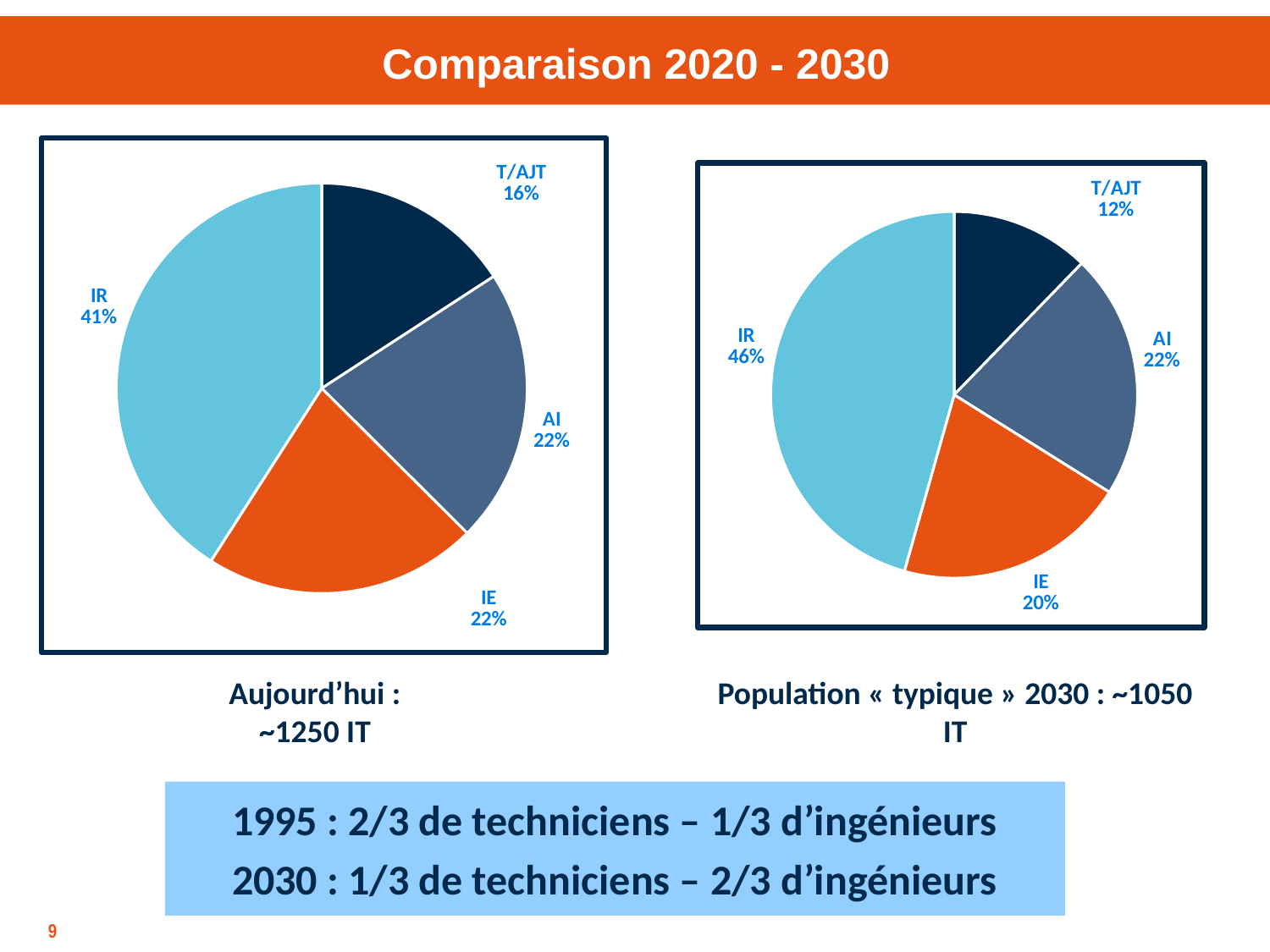
How many categories are shown in the left pie chart (Aujourd'hui)? 4 In the right pie chart (2030), which category has the smallest share? T/AJT In the right pie chart (Population « typique » 2030), what share does T/AJT have? 12% What type of chart is used on this slide? Pie chart What is the title of the slide containing the two pie charts? Comparaison 2020 - 2030 In the left pie chart (Aujourd'hui : ~1250 IT), what share does IR have? 41% In the left pie chart (Aujourd'hui), which is larger: the share of IR or the share of AI? IR In the left pie chart (Aujourd'hui), which category has the smallest share? T/AJT In the right pie chart (2030), which category has the largest share? IR What is the difference between the IR share in the right pie chart (2030) and the IR share in the left pie chart (Aujourd'hui)? 5 percentage points In the left pie chart (Aujourd'hui), what share does T/AJT have? 16% In the right pie chart (2030), what share does IE have? 20%